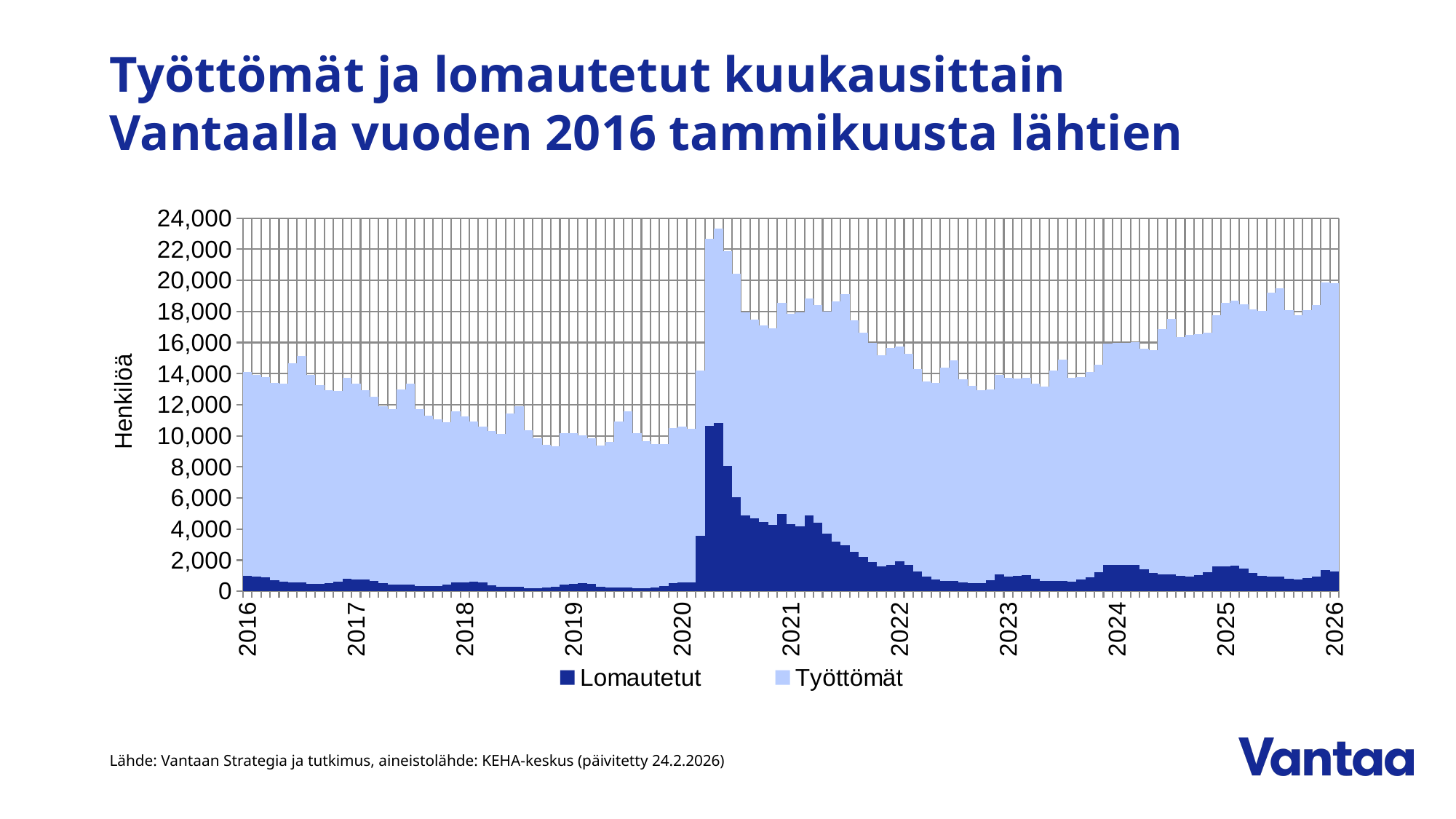
How many series does the legend list? 2 Which series is larger during 2018, Lomautetut or Työttömät? Työttömät In which year does the combined total of Lomautetut and Työttömät reach its highest peak? 2020 Does the combined total rise or fall from 2023 to 2026? Rise What are the two series named in the legend? Lomautetut and Työttömät Is the combined total at the start of 2016 greater or less than 12,000? greater What is the label on the vertical axis? Henkilöä How many year labels are shown along the x axis? 11 Is the combined total at the start of 2026 greater or less than 18,000? greater Is the value for Lomautetut during 2018 greater or less than 2,000? less What kind of chart is shown on the slide? Stacked bar chart